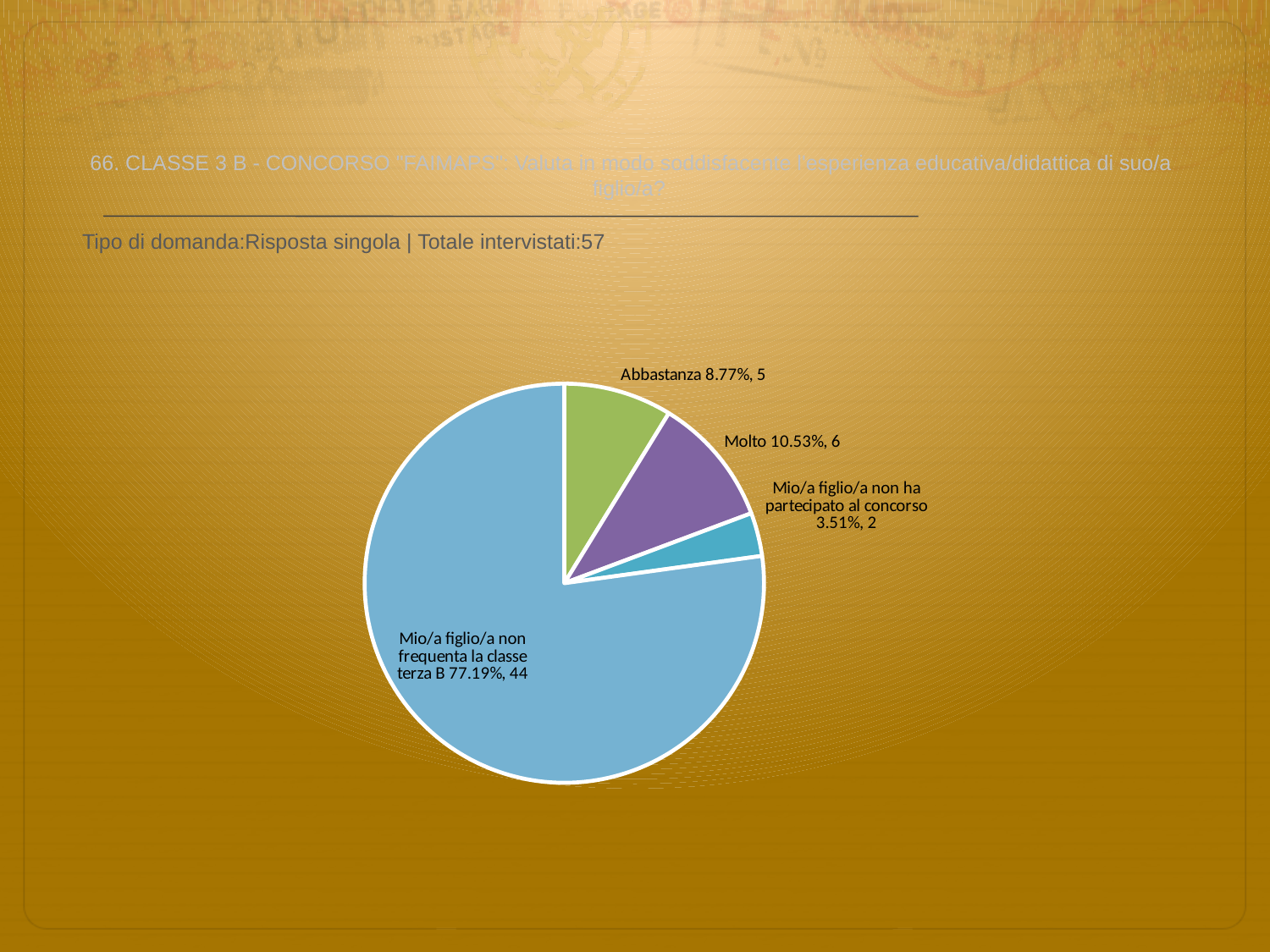
What is the count for "Molto"? 6 What share of the pie does "Molto" represent? 10.53% Which category has the smallest slice? Mio/a figlio/a non ha partecipato al concorso What percentage is shown for "Abbastanza"? 8.77% Which category has the largest slice? Mio/a figlio/a non frequenta la classe terza B What percentage is shown for "Mio/a figlio/a non ha partecipato al concorso"? 3.51% How many slices does the pie chart have? 4 What is the count for "Mio/a figlio/a non frequenta la classe terza B"? 44 What is the total number of respondents stated on the slide? 57 What kind of chart is shown on the slide? pie chart What is the difference in count between "Molto" and "Abbastanza"? 1 Which is larger, the count for "Molto" or the count for "Mio/a figlio/a non ha partecipato al concorso"? Molto